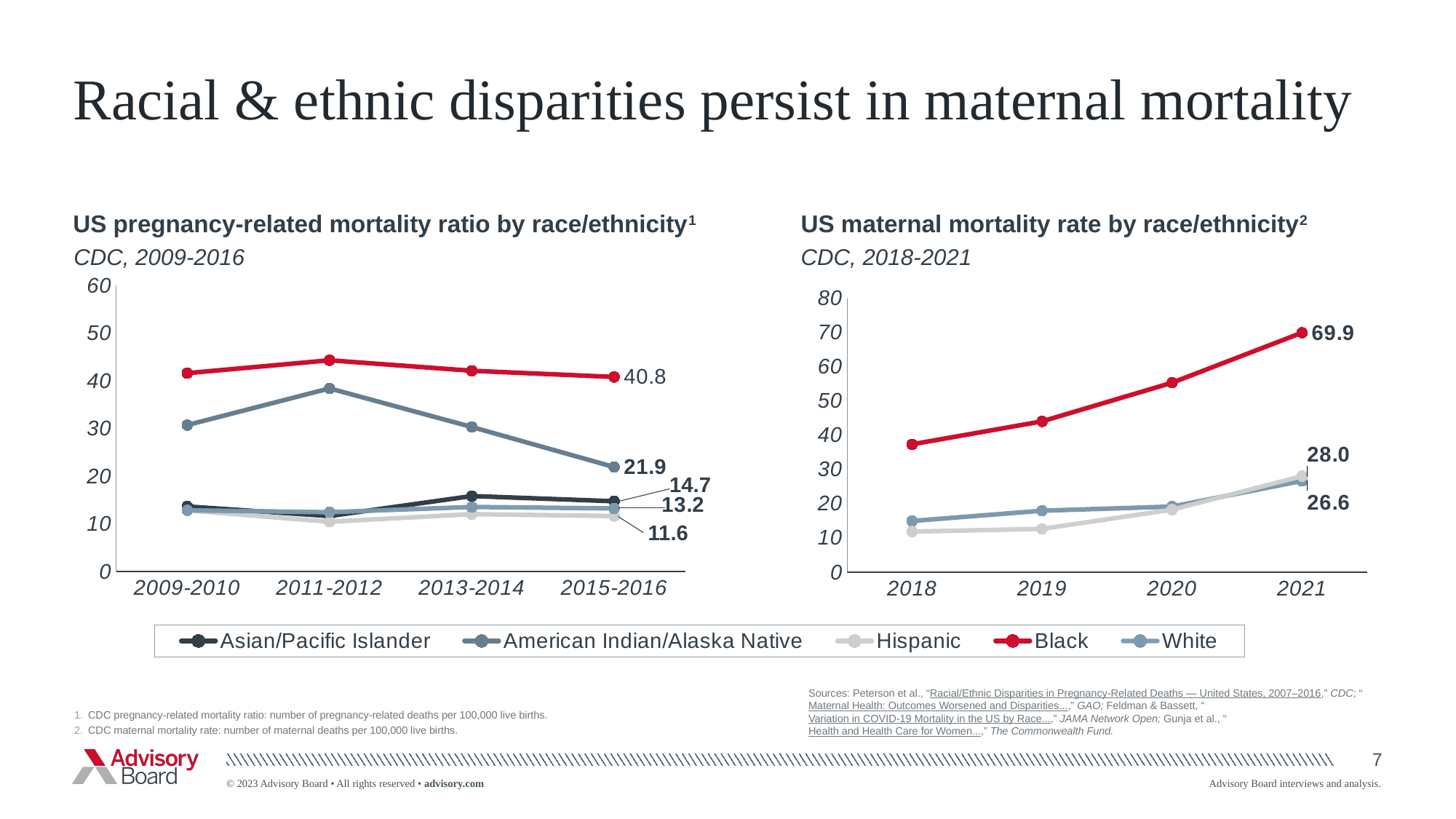
In the chart titled "US pregnancy-related mortality ratio by race/ethnicity", which group has the lowest value in 2015-2016? Hispanic In the chart titled "US pregnancy-related mortality ratio by race/ethnicity", which group has the highest value in 2015-2016? Black In the chart titled "US maternal mortality rate by race/ethnicity", is the value for Black in 2018 greater or less than 30? greater In the chart titled "US maternal mortality rate by race/ethnicity", does the Black line rise or fall from 2018 to 2021? rises In the chart titled "US maternal mortality rate by race/ethnicity", what is the value for Hispanic in 2021? 28.0 In the chart titled "US maternal mortality rate by race/ethnicity", what is the difference between the Black and White values in 2021? 43.3 In the chart titled "US pregnancy-related mortality ratio by race/ethnicity", what is the value for Black in 2015-2016? 40.8 In the chart titled "US pregnancy-related mortality ratio by race/ethnicity", which is larger in 2015-2016: Asian/Pacific Islander or White? Asian/Pacific Islander How many series does the legend on the slide list? 5 In the chart titled "US pregnancy-related mortality ratio by race/ethnicity", what is the difference between the Black and American Indian/Alaska Native values in 2015-2016? 18.9 In the chart titled "US maternal mortality rate by race/ethnicity", what is the value for Black in 2021? 69.9 In the chart titled "US pregnancy-related mortality ratio by race/ethnicity", what is the value for American Indian/Alaska Native in 2015-2016? 21.9